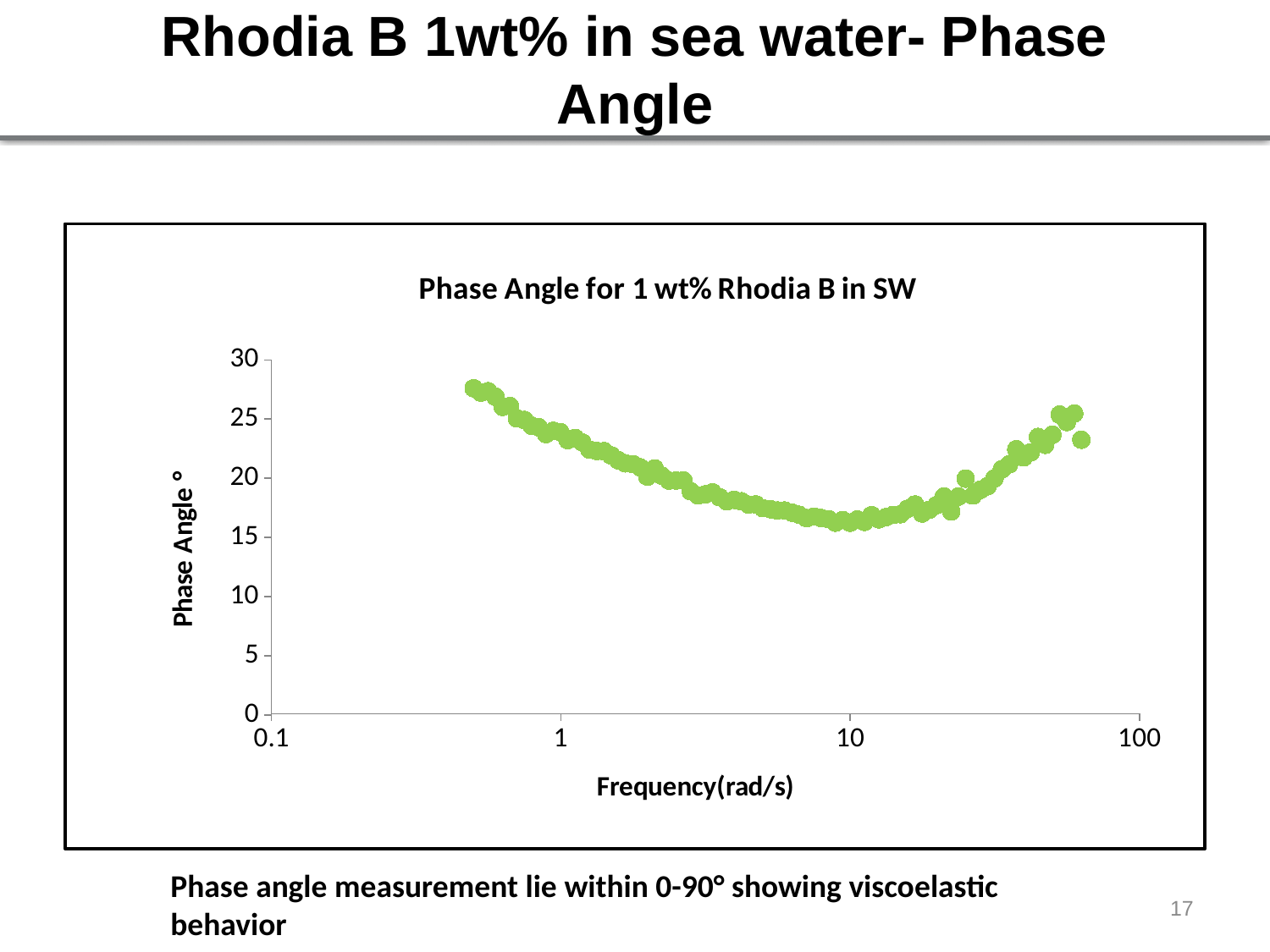
Is the phase angle at the lowest plotted frequency (around 0.5 rad/s) greater or less than 25? greater What is the label of the x axis of the chart? Frequency(rad/s) What kind of chart is shown on the slide? scatter plot Around which frequency on the x axis do the phase angle values reach their lowest point? 10 rad/s Which has the larger phase angle: the point at 1 rad/s or the point at 10 rad/s? 1 rad/s Between frequencies of 1 and 10 rad/s, do the phase angle values rise or fall as frequency increases? fall Between frequencies of 10 and 100 rad/s, do the phase angle values rise or fall as frequency increases? rise What is the highest value shown on the y axis of the chart? 30 Is the phase angle at a frequency of 10 rad/s greater or less than 15? greater Is the phase angle at a frequency of 1 rad/s greater or less than 20? greater What is the title of the chart? Phase Angle for 1 wt% Rhodia B in SW